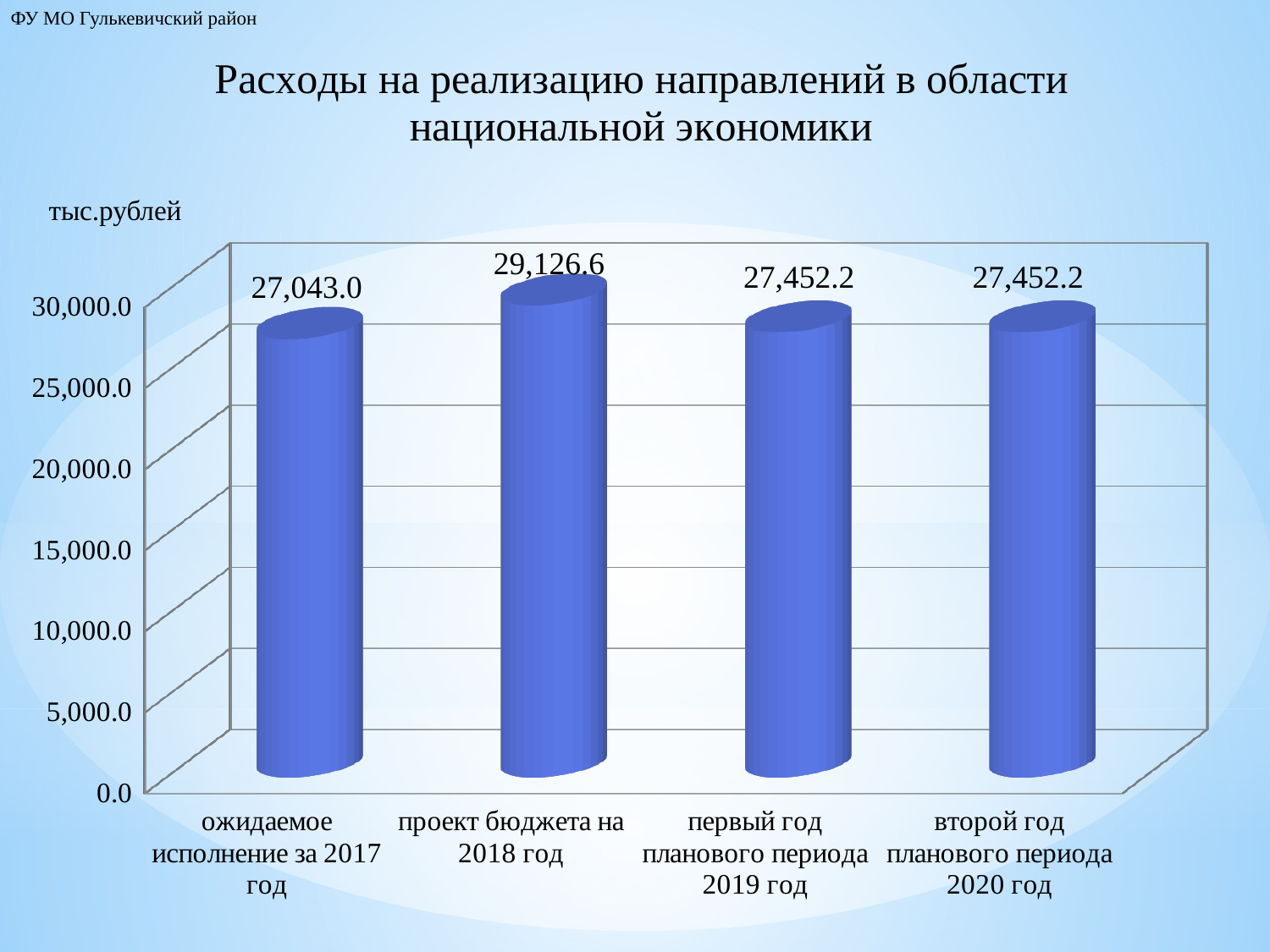
Which category has the lowest value? ожидаемое исполнение за 2017 год What kind of chart is shown on the slide? bar chart Which is larger: the value for 'проект бюджета на 2018 год' or the value for 'второй год планового периода 2020 год'? проект бюджета на 2018 год How many categories are shown on the chart? 4 What is the value for 'проект бюджета на 2018 год'? 29,126.6 Is the value for 'ожидаемое исполнение за 2017 год' greater or less than 25,000.0? greater What is the value for 'первый год планового периода 2019 год'? 27,452.2 What is the value for 'ожидаемое исполнение за 2017 год'? 27,043.0 What is the difference between the value for 'первый год планового периода 2019 год' and the value for 'ожидаемое исполнение за 2017 год'? 409.2 What unit of measurement is indicated above the chart? тыс.рублей Which category has the highest value? проект бюджета на 2018 год What is the difference between the value for 'проект бюджета на 2018 год' and the value for 'ожидаемое исполнение за 2017 год'? 2,083.6